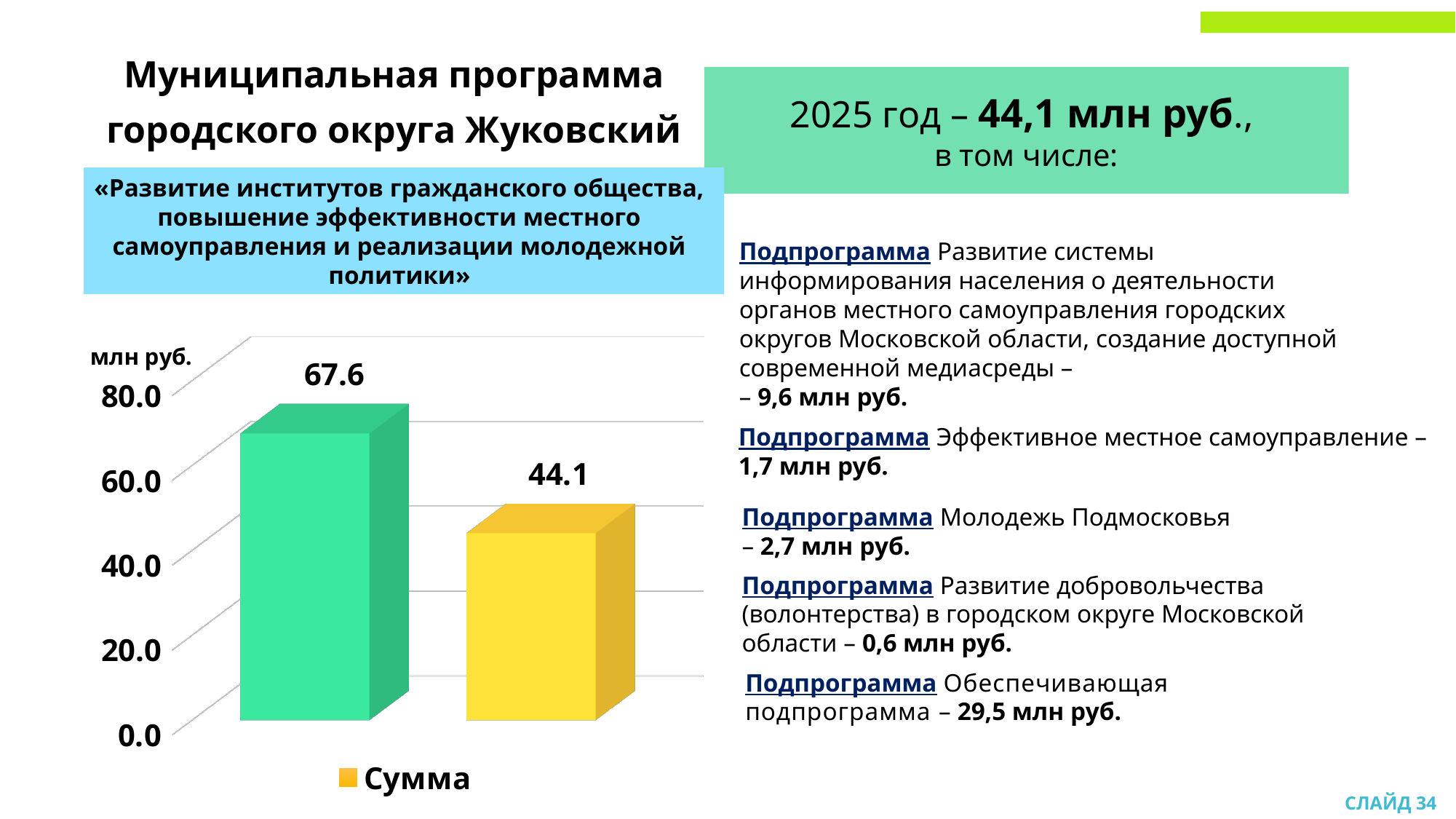
What is the value shown on the right (yellow) bar? 44.1 What is the name of the series shown in the chart legend? Сумма Is the value of the right (yellow) bar greater or less than 60.0? less What is the difference between the values of the left bar and the right bar? 23.5 What type of chart is shown on the slide? bar chart How many series does the chart legend list? 1 Which bar has the higher value, the left green bar or the right yellow bar? the left green bar What is the value shown on the left (green) bar? 67.6 What unit is indicated on the chart's vertical axis? млн руб. How many bars are plotted in the chart? 2 Do the bar values rise or fall from left to right? fall Is the value of the left (green) bar greater or less than 60.0? greater